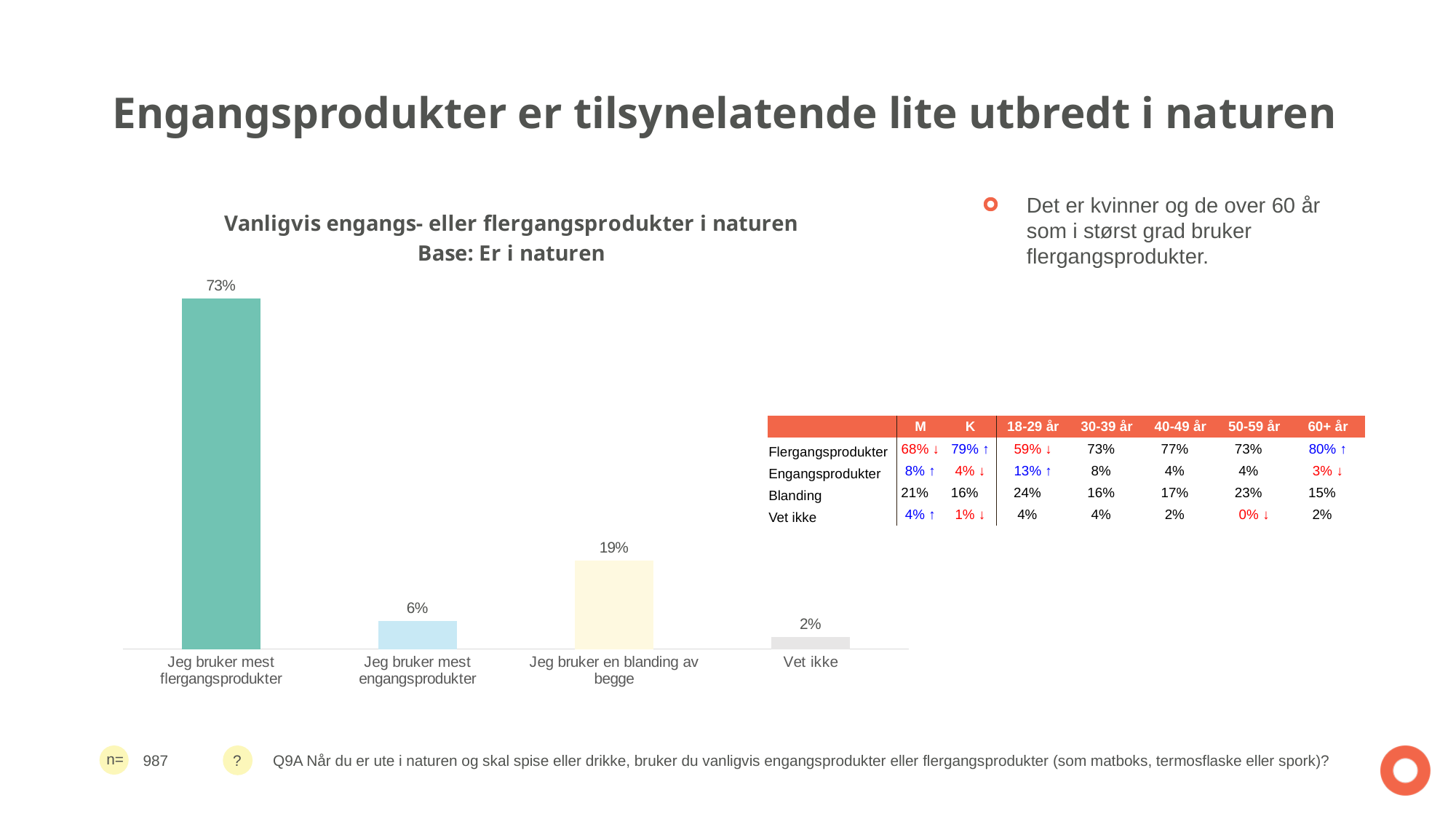
What is the value for "Vet ikke"? 2% What is the value for "Jeg bruker mest flergangsprodukter"? 73% Which category has the highest value? Jeg bruker mest flergangsprodukter How many categories are shown in the chart? 4 What is the title of the chart? Vanligvis engangs- eller flergangsprodukter i naturen Base: Er i naturen What kind of chart is shown on the slide? Bar chart Which is larger: "Jeg bruker mest engangsprodukter" or "Jeg bruker en blanding av begge"? Jeg bruker en blanding av begge What is the difference between "Jeg bruker en blanding av begge" and "Jeg bruker mest engangsprodukter"? 13% What is the value for "Jeg bruker mest engangsprodukter"? 6% Which category has the lowest value? Vet ikke What is the difference between "Jeg bruker mest flergangsprodukter" and "Jeg bruker en blanding av begge"? 54% What is the value for "Jeg bruker en blanding av begge"? 19%